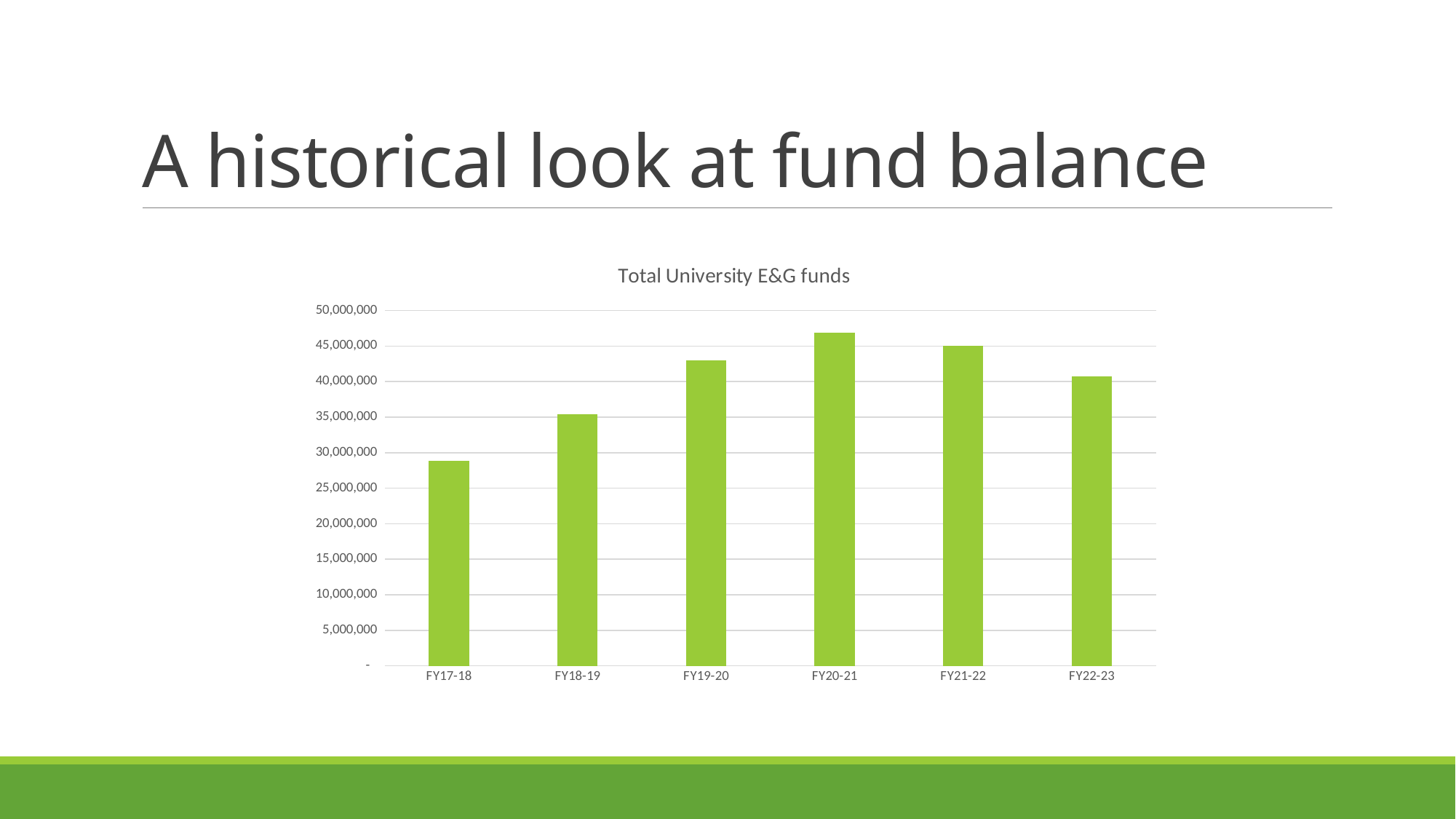
What type of chart is shown on the slide? Bar chart How many fiscal years are shown on the x axis of the chart? 6 Which is larger, the value for FY21-22 or the value for FY22-23? FY21-22 How do the values change from FY17-18 to FY22-23 along the x axis? They rise until FY20-21, then fall Which fiscal year has the lowest total University E&G funds? FY17-18 Is the value for FY19-20 greater or less than 40,000,000? greater Which is larger, the value for FY19-20 or the value for FY18-19? FY19-20 Is the value for FY20-21 greater or less than 45,000,000? greater Is the value for FY22-23 greater or less than 45,000,000? less What is the title of the chart? Total University E&G funds Which fiscal year has the highest total University E&G funds? FY20-21